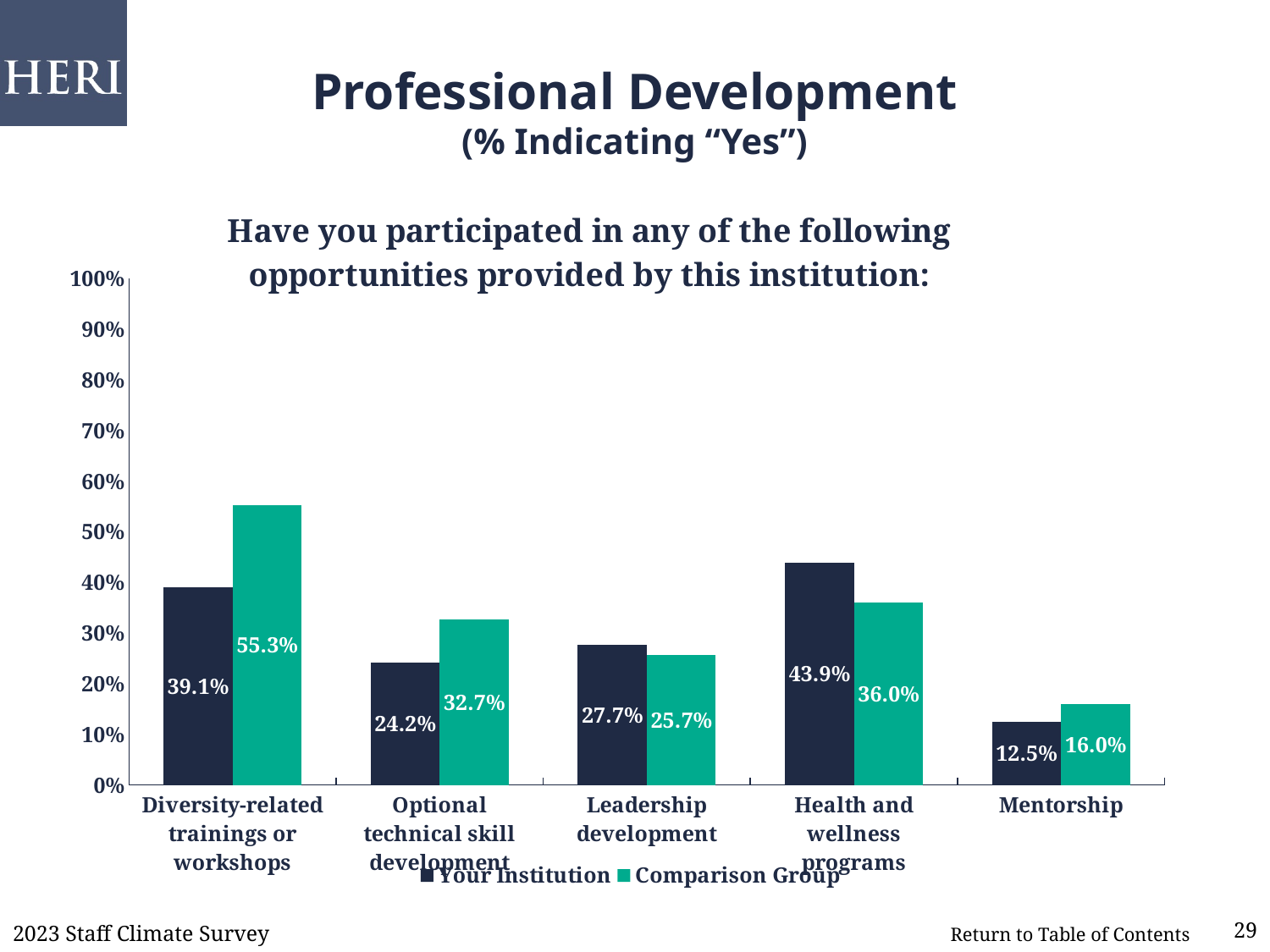
How many categories are shown on the x axis? 5 For Leadership development, which series has the larger value, Your Institution or Comparison Group? Your Institution Which category has the lowest Your Institution value? Mentorship How many series does the legend list? 2 What is the difference between the Comparison Group and Your Institution values for Diversity-related trainings or workshops? 16.2% What kind of chart is shown on the slide? Bar chart What is the difference between the Your Institution and Comparison Group values for Health and wellness programs? 7.9% What is the Comparison Group value for Mentorship? 16.0% What is the Your Institution value for Health and wellness programs? 43.9% Is the Comparison Group value for Optional technical skill development greater or less than 30%? greater What percentage of Your Institution respondents participated in Diversity-related trainings or workshops? 39.1% Which category has the highest Comparison Group value? Diversity-related trainings or workshops